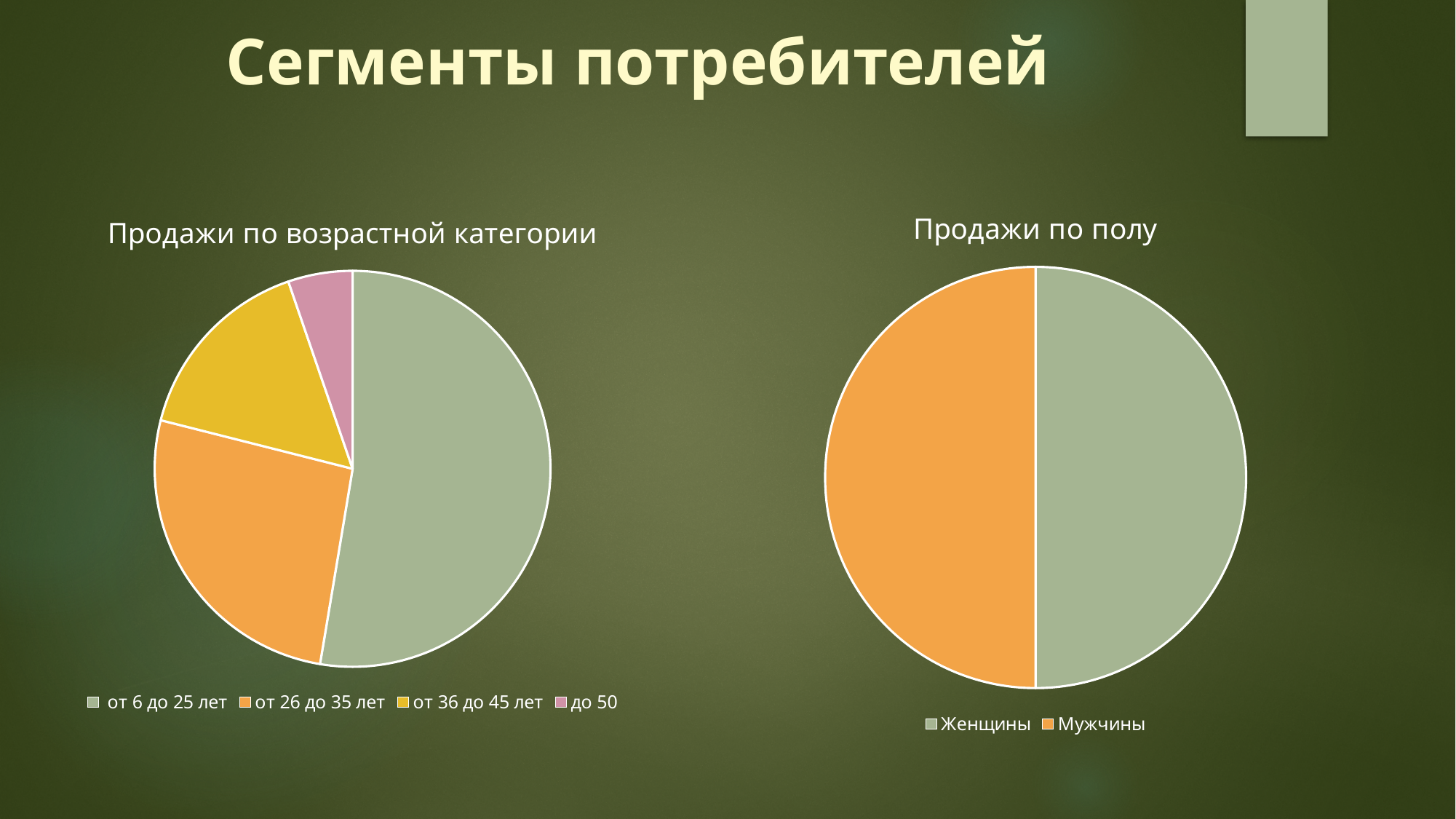
In the chart titled "Продажи по возрастной категории", which slice is larger: "от 6 до 25 лет" or "от 26 до 35 лет"? от 6 до 25 лет How many categories does the chart titled "Продажи по полу" show? 2 In the chart titled "Продажи по возрастной категории", which category has the smallest slice? до 50 What kind of chart is the chart titled "Продажи по полу"? pie chart In the chart titled "Продажи по возрастной категории", which slice is larger: "от 36 до 45 лет" or "до 50"? от 36 до 45 лет What is the title of the pie chart on the right of the slide? Продажи по полу In the chart titled "Продажи по возрастной категории", which slice is larger: "от 26 до 35 лет" or "от 36 до 45 лет"? от 26 до 35 лет How many categories does the chart titled "Продажи по возрастной категории" show? 4 In the chart titled "Продажи по возрастной категории", which category has the largest slice? от 6 до 25 лет In the chart titled "Продажи по полу", which category is shown in orange? Мужчины What kind of chart is the chart titled "Продажи по возрастной категории"? pie chart